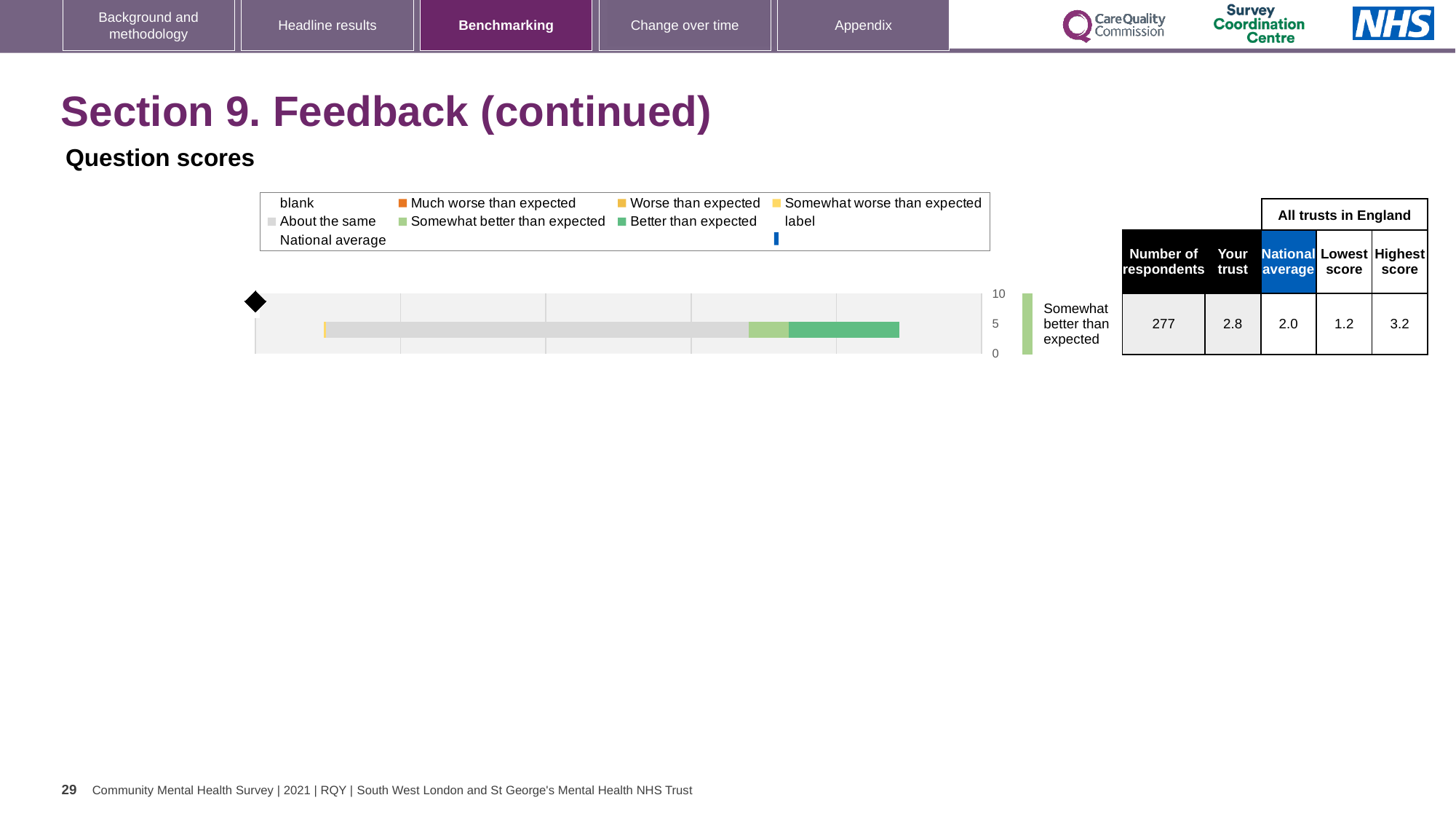
In the table beside the chart, what is the difference between the highest score and the lowest score? 2.0 In the table beside the chart, what is the score for 'Your trust'? 2.8 What benchmark category label is shown next to the bar? Somewhat better than expected In the table beside the chart, what is the national average score? 2.0 Which segment of the bar is the widest? About the same In the table beside the chart, what is the number of respondents? 277 In the table beside the chart, which is larger: the 'Your trust' score or the national average? Your trust Which legend entry is shown in orange? Much worse than expected What is the highest tick value shown on the chart axis? 10 What colour is the 'About the same' segment in the legend? grey How many bars are plotted in the chart? 1 What kind of chart is shown on the slide? bar chart